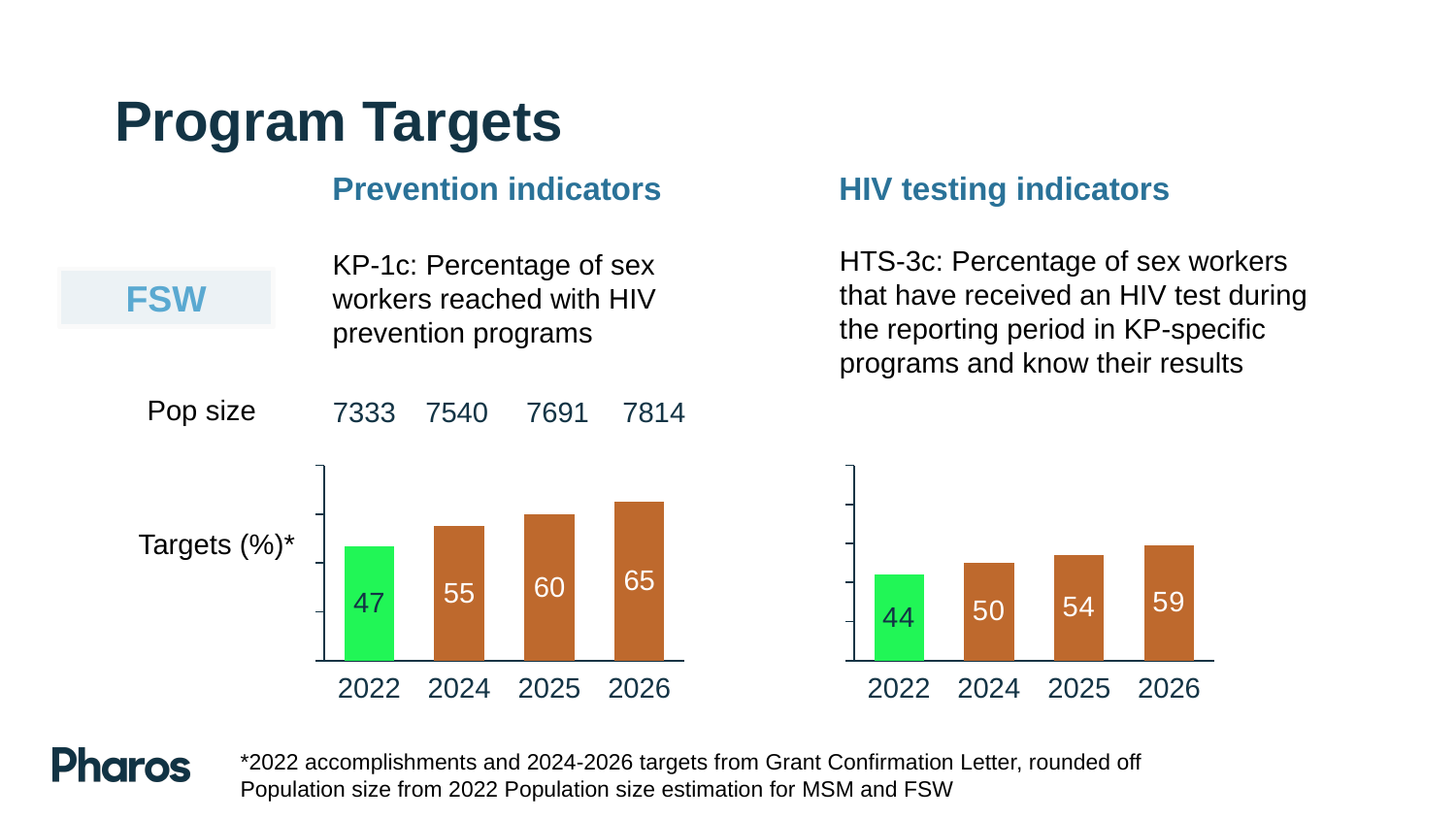
In the HIV testing indicators chart (right), do the values rise or fall from 2022 to 2026? Rise In the HIV testing indicators chart (right), what is the value for 2022? 44 In the Prevention indicators chart (left), which year has the lowest value? 2022 In the Prevention indicators chart (left), which bar is coloured green rather than brown? 2022 In the HIV testing indicators chart (right), which year has the highest value? 2026 What type of chart is used for the Prevention indicators (left)? Bar chart Which is larger: the 2025 value in the Prevention indicators chart (left) or the 2025 value in the HIV testing indicators chart (right)? Prevention indicators (60) In the Prevention indicators chart (left), what is the target value for 2026? 65 In the HIV testing indicators chart (right), what is the difference between the 2025 and 2024 values? 4 How many years are shown on the x axis of the HIV testing indicators chart (right)? 4 In the Prevention indicators chart (left), what is the value for 2024? 55 In the Prevention indicators chart (left), what is the difference between the 2026 and 2022 values? 18